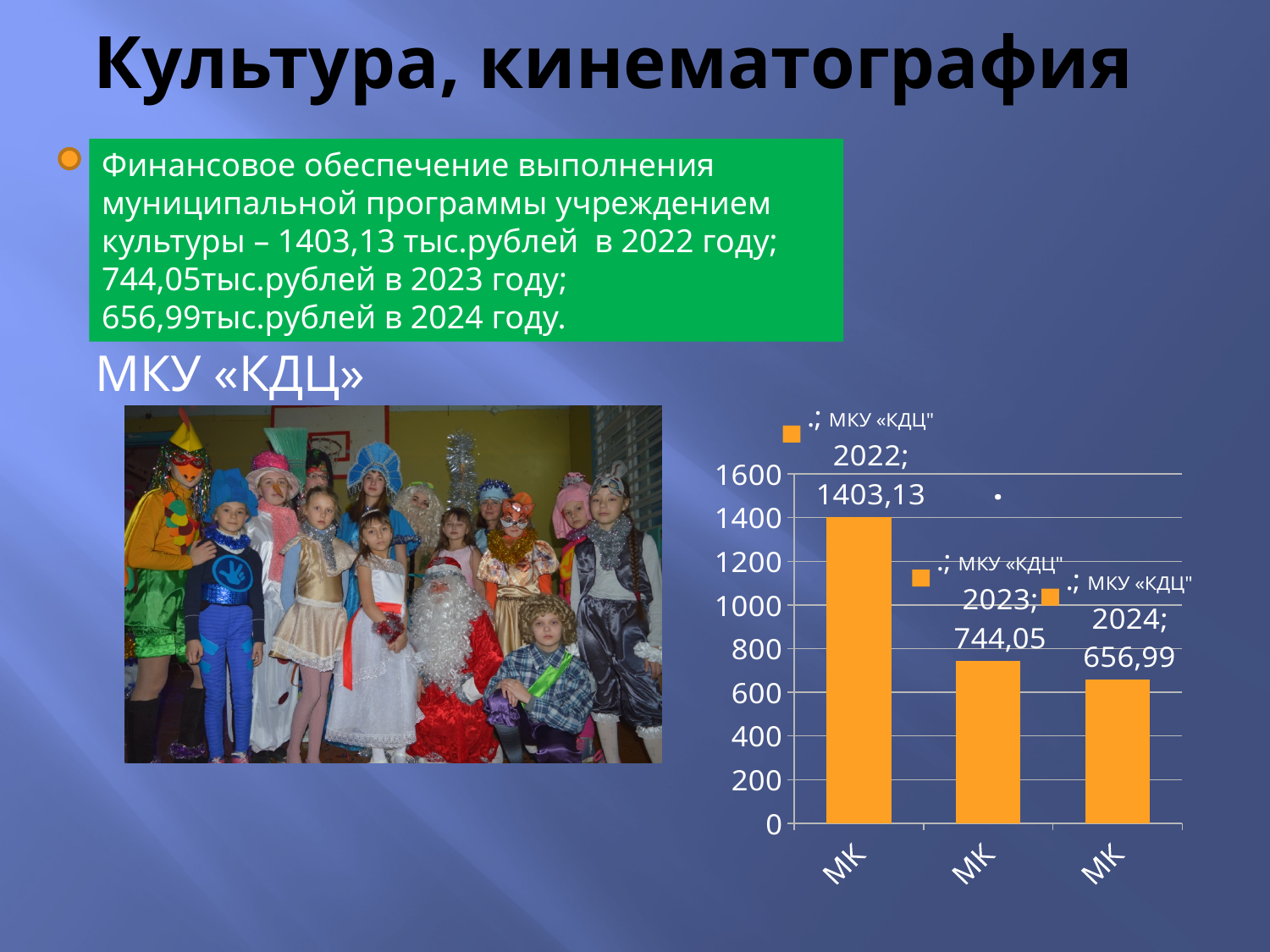
Do the values rise or fall from 2022 to 2024? fall Which year has the highest value on the chart? 2022 How many bars are plotted on the chart? 3 Is the value for 2022 greater or less than 1400? greater What kind of chart is shown on the slide? bar chart Which year has the lowest value on the chart? 2024 Which is larger, the value for 2023 or the value for 2024? 2023 What is the value shown for 2023 on the chart? 744,05 What is the value shown for 2022 on the chart? 1403,13 What is the difference between the 2023 value and the 2024 value? 87,06 What is the difference between the 2022 value and the 2023 value? 659,08 What is the value shown for 2024 on the chart? 656,99